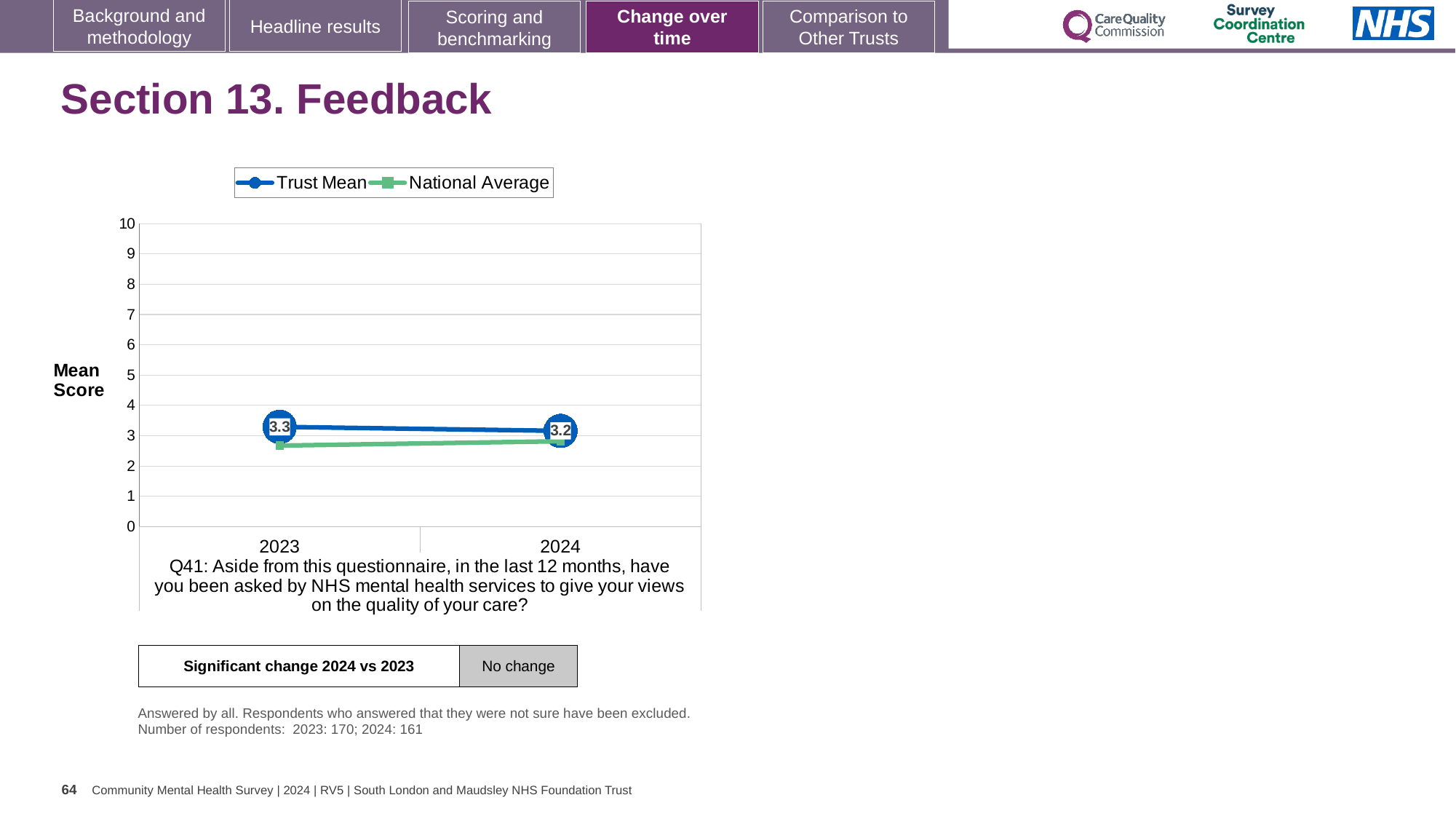
How many years are plotted on the x axis? 2 What is the Trust Mean score for 2023? 3.3 Does the Trust Mean rise or fall from 2023 to 2024? fall Is the National Average value for 2023 greater or less than 3? less What is the label on the y axis of the chart? Mean Score What is the Trust Mean score for 2024? 3.2 What kind of chart is shown on the slide? line chart What is the difference between the Trust Mean scores for 2023 and 2024? 0.1 What are the two series named in the legend? Trust Mean and National Average In 2023, which is higher, the Trust Mean or the National Average? Trust Mean Which year has the higher Trust Mean score, 2023 or 2024? 2023 How many series does the legend list? 2